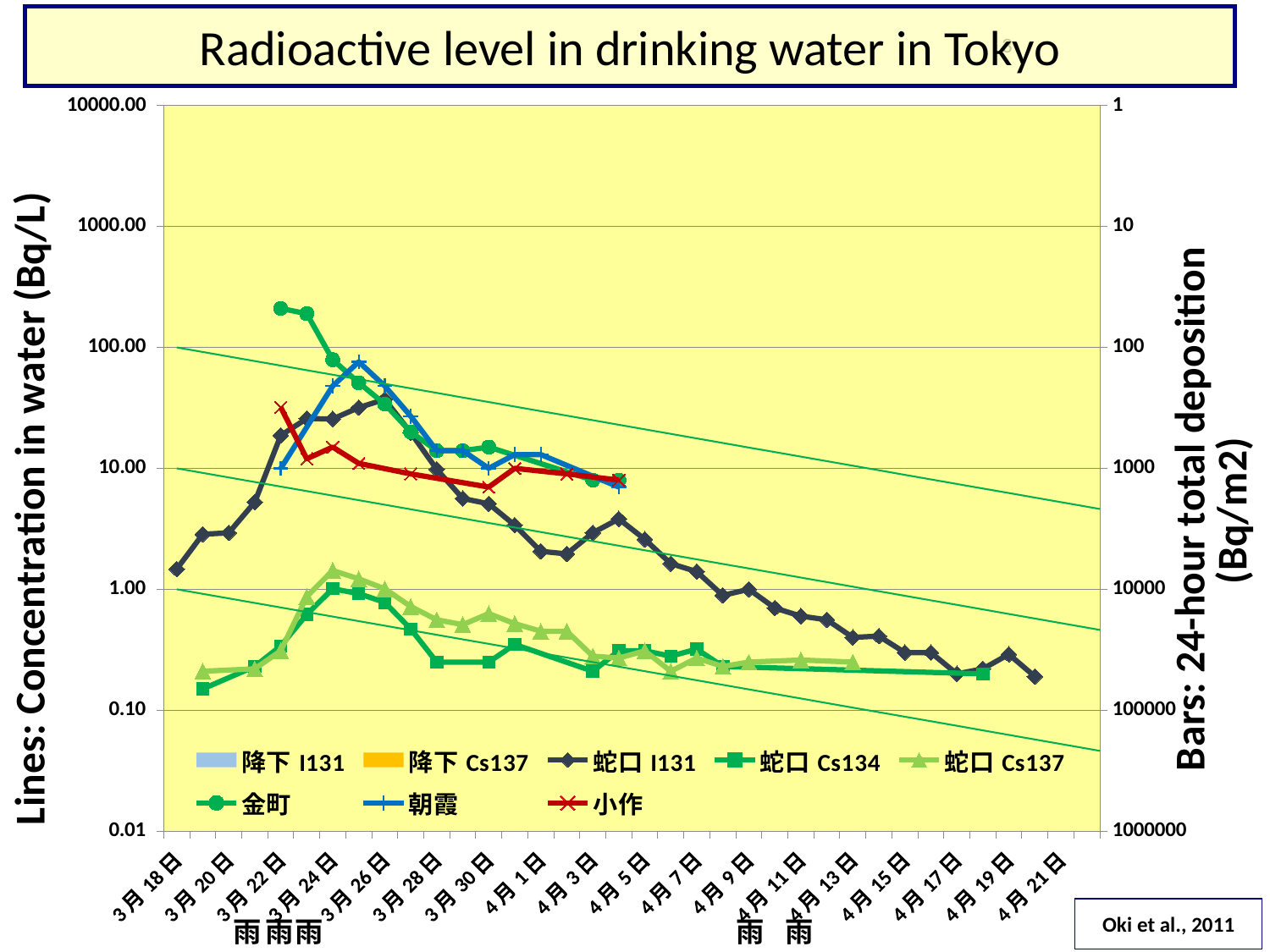
What is the label of the left vertical axis? Lines: Concentration in water (Bq/L) Is the value for 朝霞 on 3月25日 greater or less than 10.00 Bq/L? greater Is the value for 蛇口 I131 on 3月18日 greater or less than 10.00 Bq/L? less How many series does the legend list? 8 Is the value for 金町 on 3月22日 greater or less than 100.00 Bq/L? greater What kind of chart is shown on the slide? line chart On 3月22日, which is higher: 金町 or 小作? 金町 What is the title of the chart? Radioactive level in drinking water in Tokyo On 3月24日, which is higher: 蛇口 I131 or 蛇口 Cs137? 蛇口 I131 Does the 蛇口 I131 series generally rise or fall from 3月26日 to 4月21日? fall Which series reaches the highest concentration on the chart? 金町